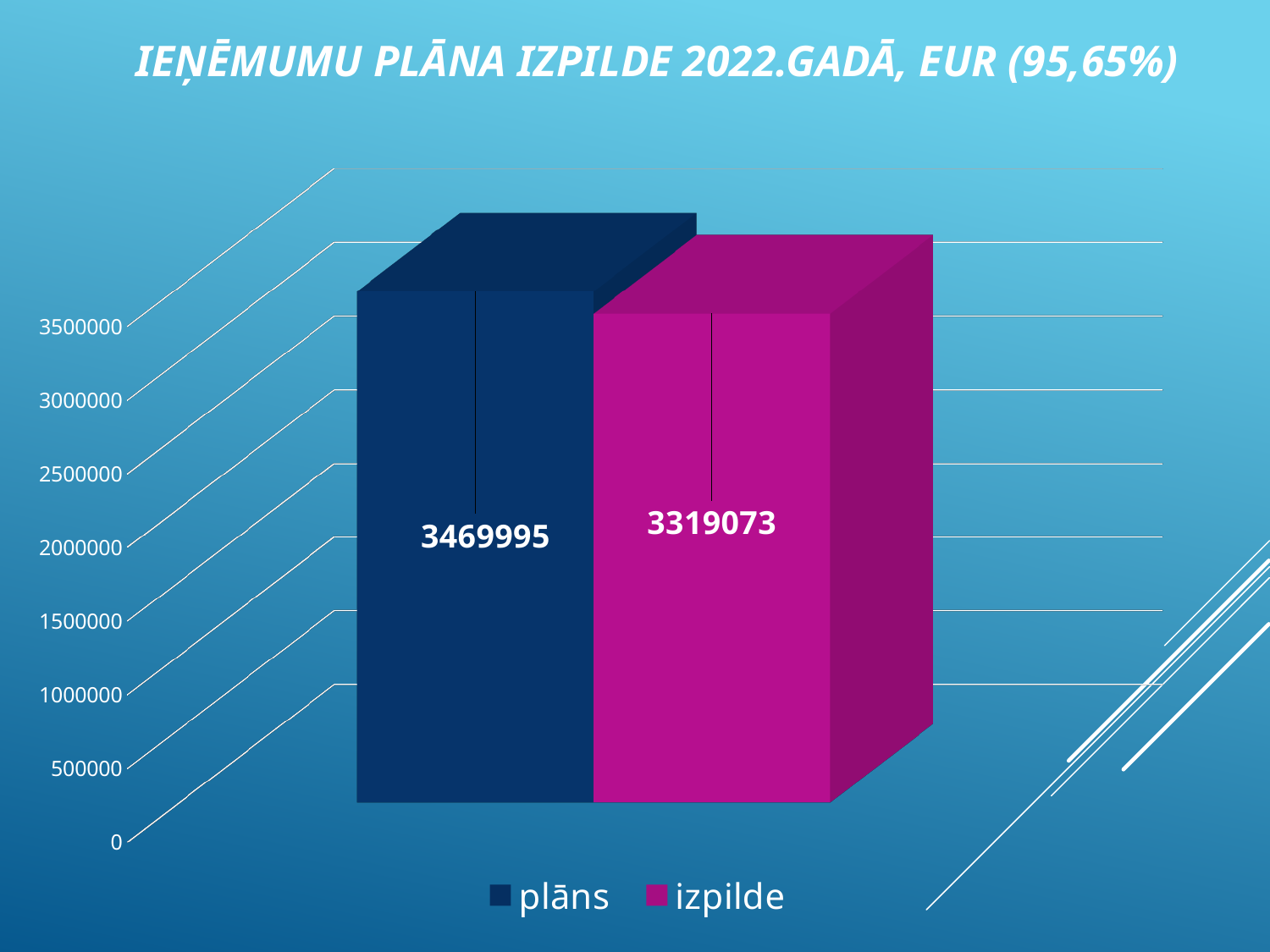
What percentage is shown in the chart title? 95,65% What kind of chart is shown on the slide? bar chart How many series does the legend list? 2 How many bars are plotted on the chart? 2 Is the value for plāns greater or less than 3500000? less What is the value for izpilde? 3319073 Which bar is the highest? plāns Which series has the higher value, plāns or izpilde? plāns Is the value for izpilde greater or less than 3000000? greater What is the value for plāns? 3469995 What is the difference between the plāns value and the izpilde value? 150922 Which bar is the lowest? izpilde